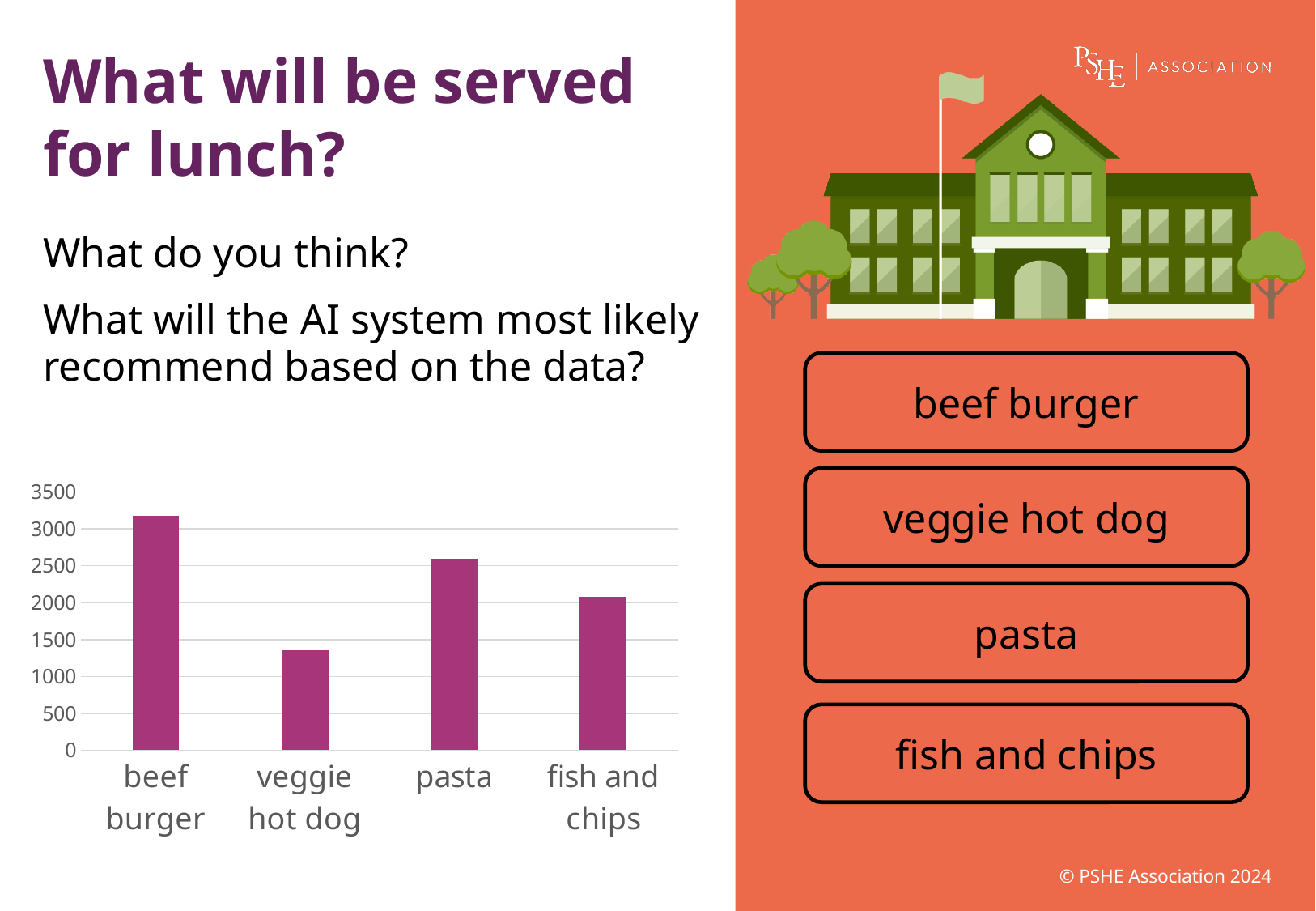
Is the value for pasta greater or less than 2000? greater Which category has the lowest value on the chart? veggie hot dog What colour are the bars in the chart? purple Which is larger, the value for beef burger or the value for veggie hot dog? beef burger Which is larger, the value for pasta or the value for fish and chips? pasta How many categories are shown on the chart? 4 Is the value for beef burger greater or less than 3000? greater Which category has the highest value on the chart? beef burger Is the value for fish and chips greater or less than 2500? less What is the highest value shown on the chart's vertical axis? 3500 What kind of chart is shown on the slide? bar chart